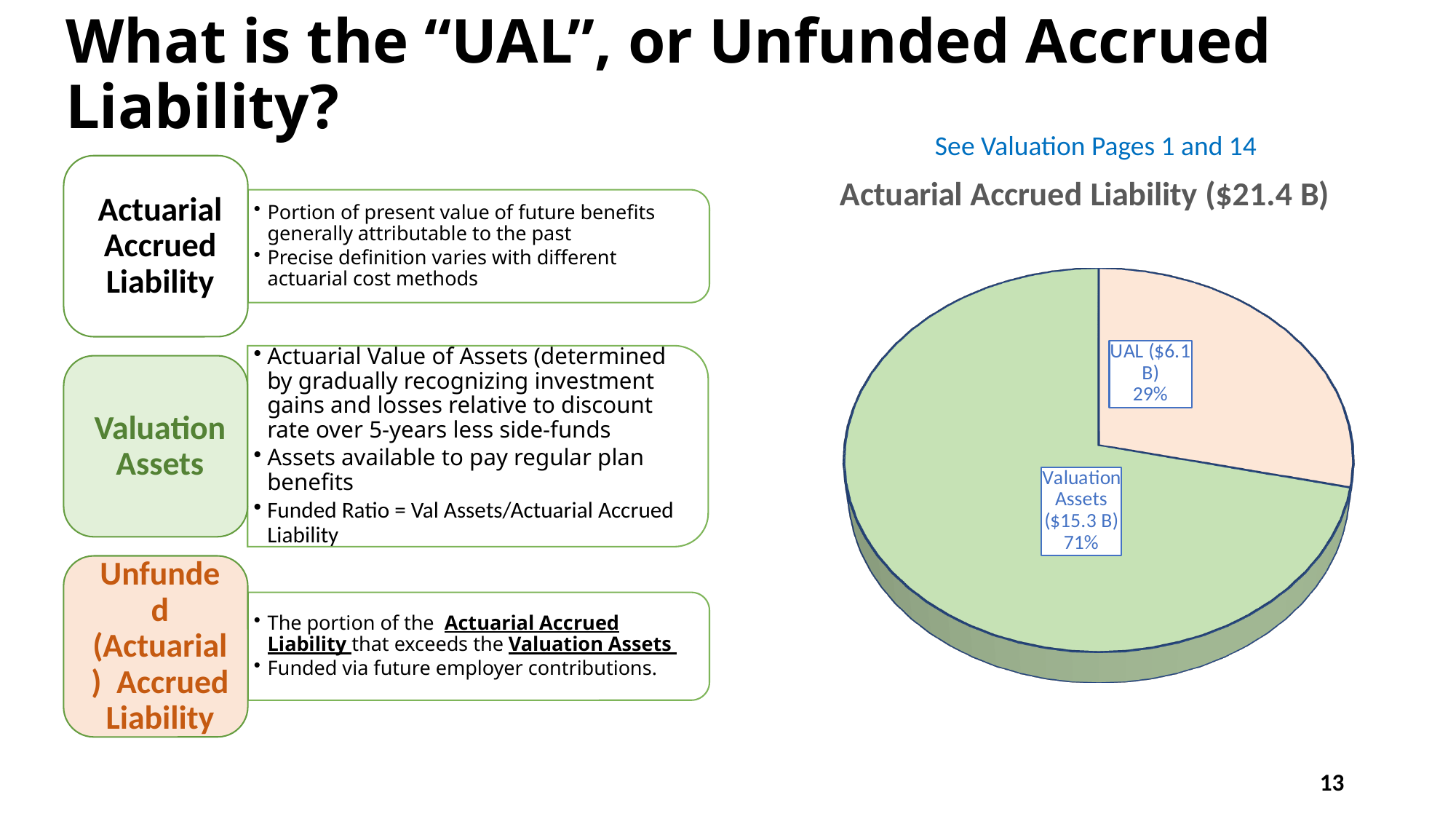
Which slice of the pie chart is the largest? Valuation Assets What is the dollar value shown for the Valuation Assets slice? $15.3 B What is the title of the pie chart? Actuarial Accrued Liability ($21.4 B) Which is larger, the Valuation Assets slice or the UAL slice? Valuation Assets What share of the pie does the Valuation Assets slice represent? 71% How many slices does the pie chart have? 2 What is the difference in percentage points between the Valuation Assets share and the UAL share? 42 percentage points What colour is the Valuation Assets slice in the pie chart? green Which slice of the pie chart is the smallest? UAL What share of the pie does the UAL slice represent? 29% What kind of chart is shown on the slide? pie chart What is the dollar value shown for the UAL slice? $6.1 B